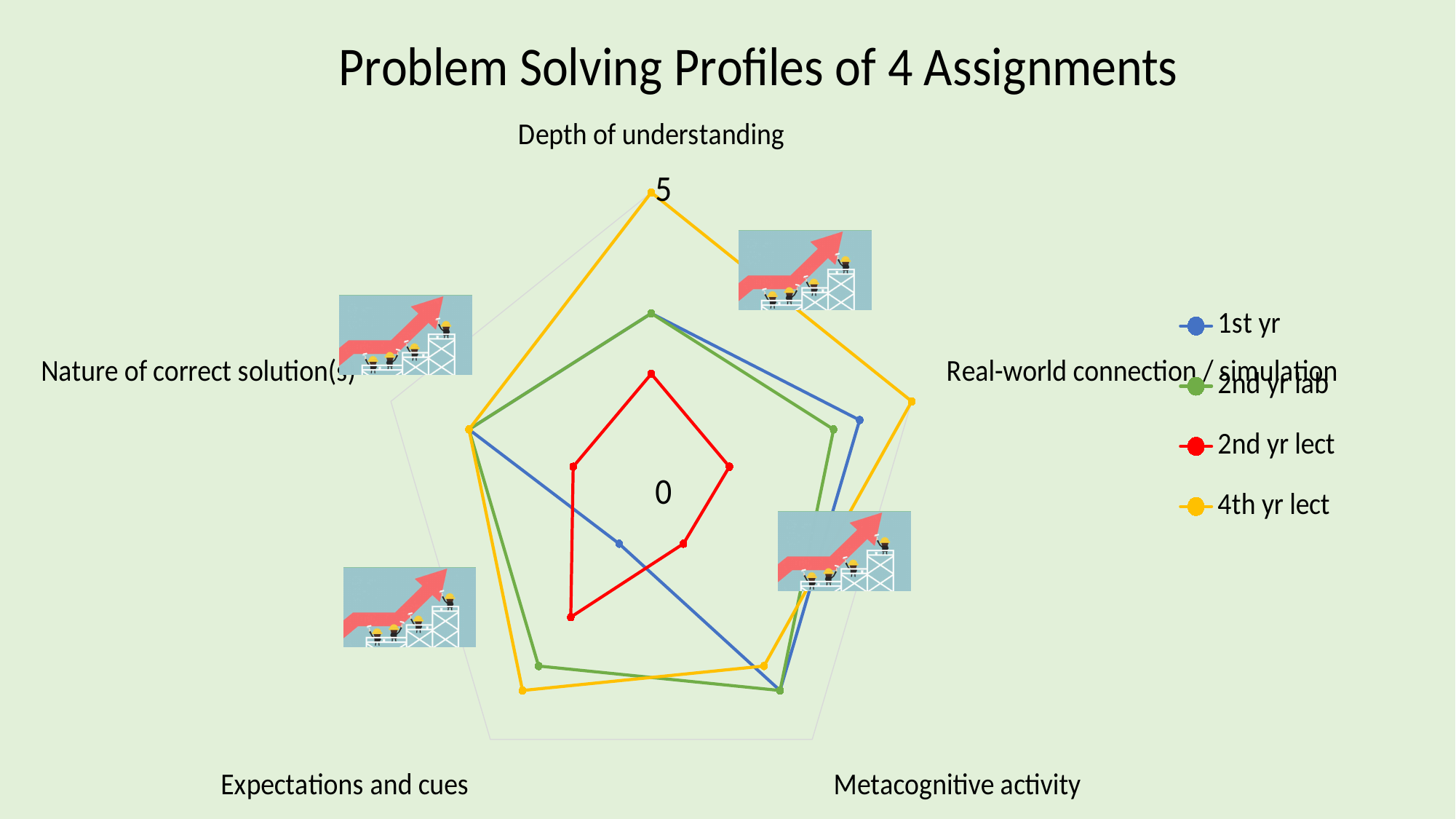
Which series has the lowest value on the Metacognitive activity axis? 2nd yr lect What is the value for 4th yr lect on the Depth of understanding axis? 5 Which series has the highest value on the Real-world connection / simulation axis? 4th yr lect Which series has the lowest value on the Depth of understanding axis? 2nd yr lect Which colour represents the 4th yr lect series in the legend? Yellow Which series has the lowest value on the Expectations and cues axis? 1st yr How many axes (categories) does the radar chart have? 5 How many series does the legend list? 4 What kind of chart is shown on the slide? Radar chart Which series has the highest value on the Depth of understanding axis? 4th yr lect On the Real-world connection / simulation axis, which is larger: 1st yr or 2nd yr lect? 1st yr What is the title of the chart? Problem Solving Profiles of 4 Assignments